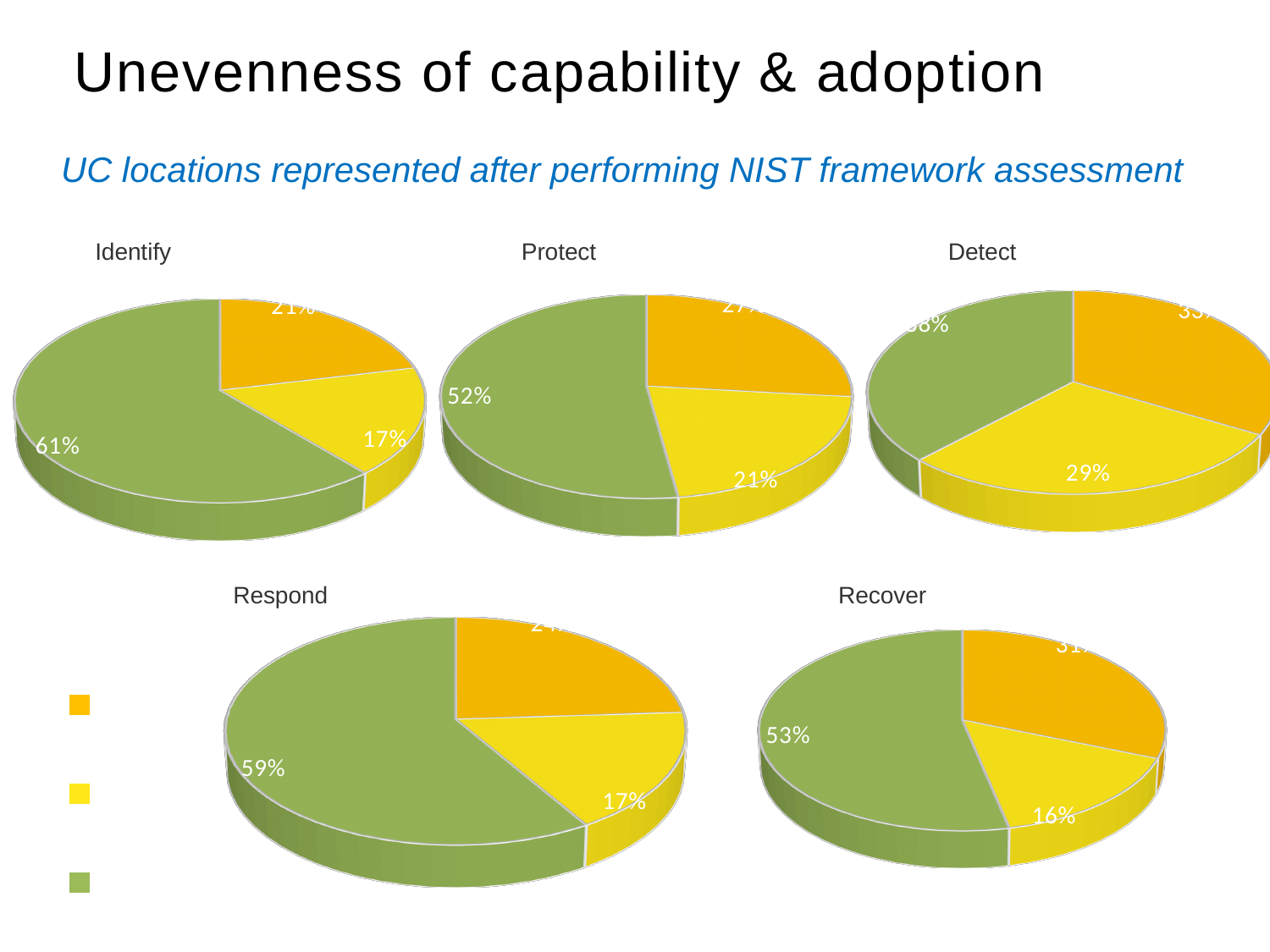
Which chart has the larger green slice, Identify or Protect? Identify In the Identify pie chart, what percentage is shown for the yellow slice? 17% In the Identify pie chart, what percentage is shown for the green slice? 61% In the Protect pie chart, what percentage is shown for the yellow slice? 21% In the Protect pie chart, what percentage is shown for the green slice? 52% In the Recover pie chart, what percentage is shown for the yellow slice? 16% What type of chart is used for the Respond data? Pie chart In the Recover pie chart, what is the difference between the green slice (53%) and the yellow slice (16%)? 37 percentage points In the Detect pie chart, what percentage is shown for the yellow slice? 29% In the Respond pie chart, what percentage is shown for the green slice? 59% In the Identify pie chart, which colour slice is the largest? Green How many pie charts are shown on the slide? 5